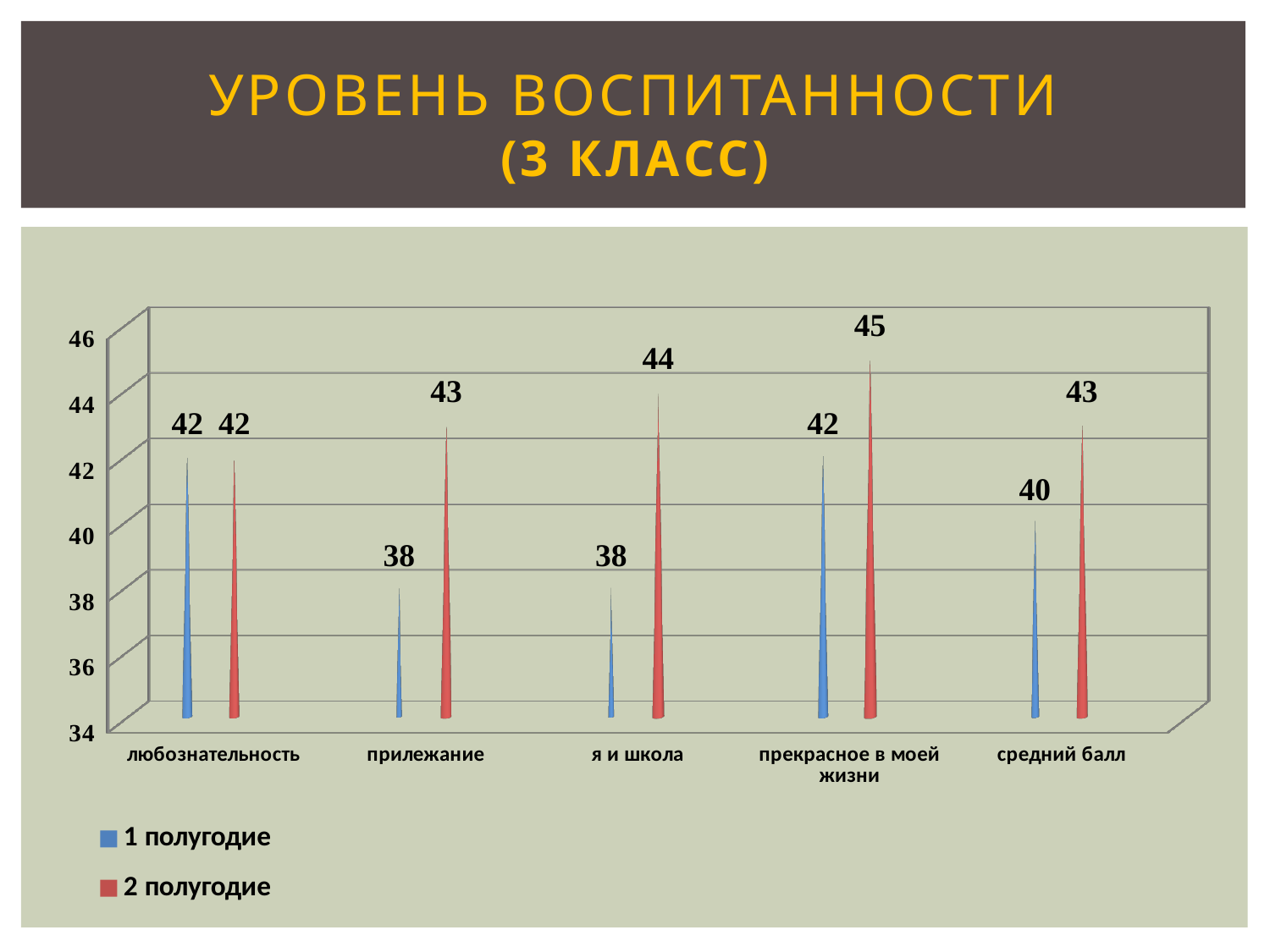
Which series is shown in red according to the legend? 2 полугодие What kind of chart is shown on the slide? bar chart What is the value for 2 полугодие in the category прекрасное в моей жизни? 45 Which is larger for средний балл: the value for 1 полугодие or for 2 полугодие? 2 полугодие How many series does the legend list? 2 What is the value for 1 полугодие in the category прилежание? 38 Which category has the highest value for 2 полугодие? прекрасное в моей жизни Which category has the lowest value for 2 полугодие? любознательность How many categories are shown on the x axis? 5 What is the value for 2 полугодие in the category средний балл? 43 What is the title of the slide? УРОВЕНЬ ВОСПИТАННОСТИ (3 КЛАСС) What is the difference between the 2 полугодие and 1 полугодие values for я и школа? 6